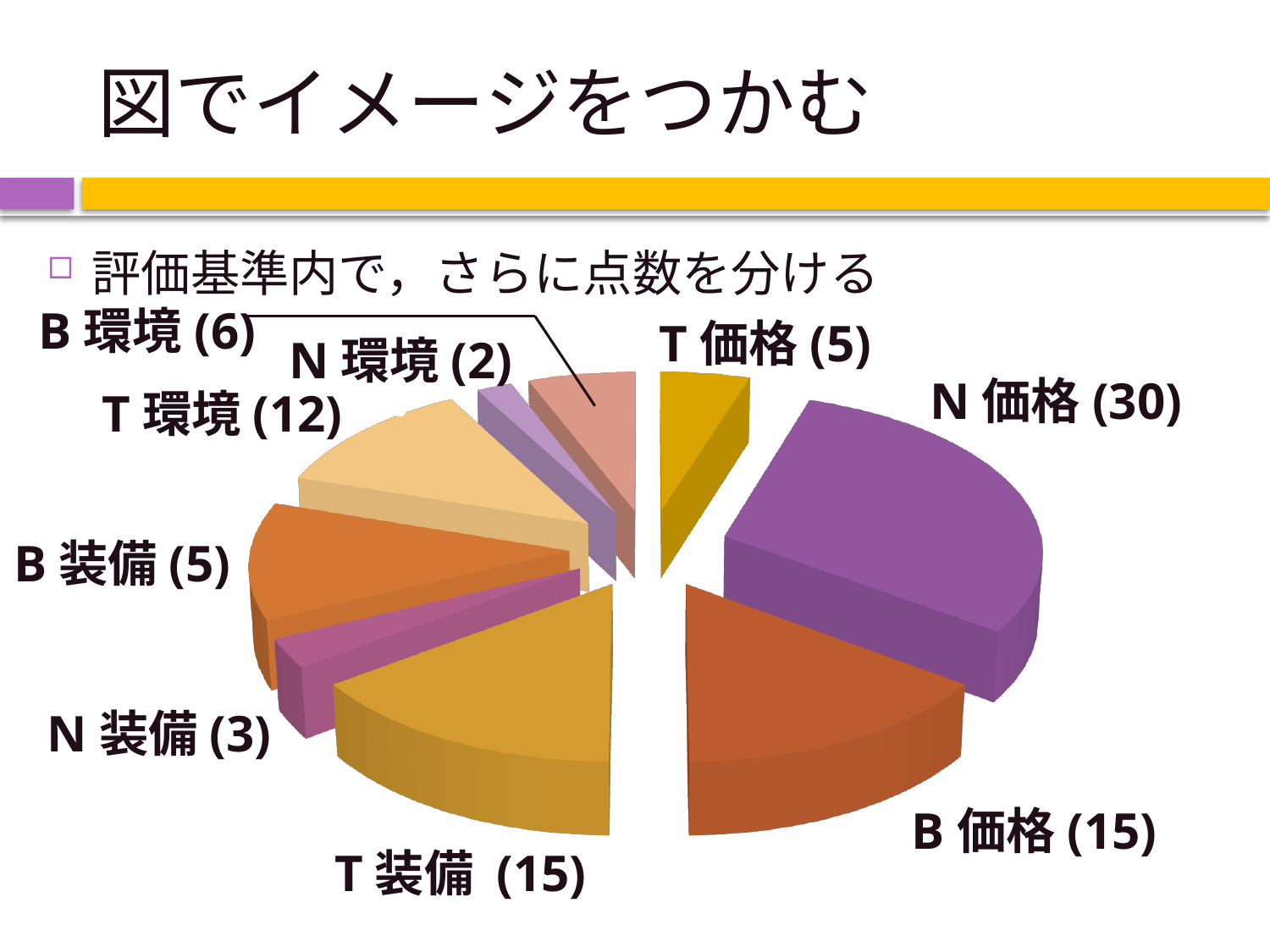
What is the value for N 装備 in the pie chart? 3 What is the title of the slide containing the pie chart? 図でイメージをつかむ What is the difference between the values for N 価格 and B 価格? 15 Which slice of the pie chart has the largest value? N 価格 What kind of chart is shown on the slide? Pie chart Which slice of the pie chart has the smallest value? N 環境 What is the value for B 環境 in the pie chart? 6 What is the total of all the values shown in the pie chart? 93 What is the value for T 環境 in the pie chart? 12 What is the value for N 価格 in the pie chart? 30 Which is larger, the value for T 環境 or the value for B 環境? T 環境 How many slices does the pie chart have? 9